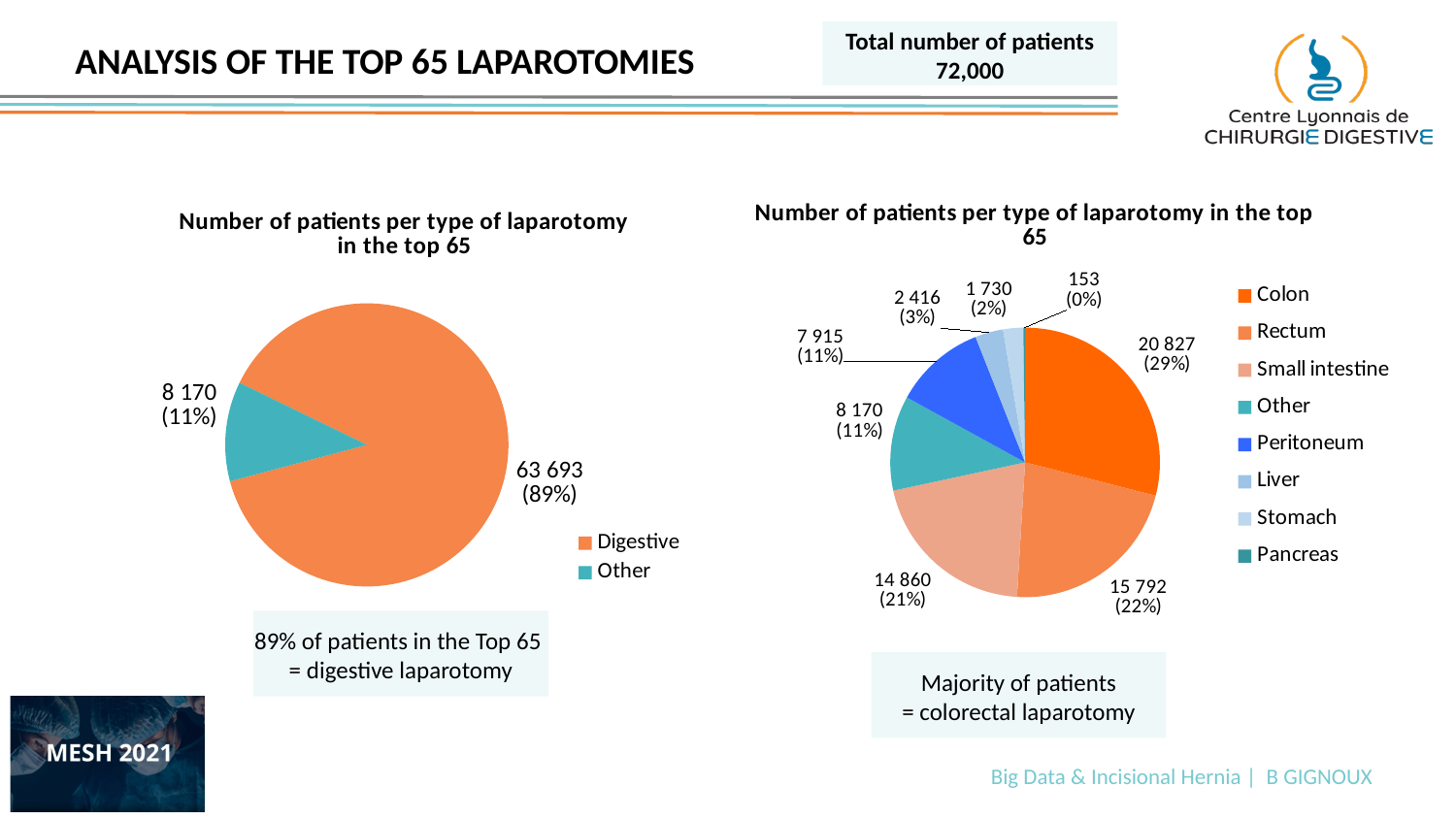
On the right pie chart, which is larger: Peritoneum or Liver? Peritoneum On the left pie chart, what is the difference between the Digestive and Other values? 55 523 On the right pie chart, how many patients are in the Colon category? 20 827 What kind of chart is the left chart? Pie chart On the right pie chart, which category has the lowest number of patients? Pancreas On the left pie chart, how many patients are in the Digestive category? 63 693 On the right pie chart, what share of patients does the Rectum slice represent? 22% How many categories does the legend of the right pie chart list? 8 On the left pie chart, what share of patients does the Other slice represent? 11% On the right pie chart, how many patients are in the Small intestine category? 14 860 On the right pie chart, which category has the highest number of patients? Colon On the right pie chart, what is the difference between the Colon and Rectum values? 5 035